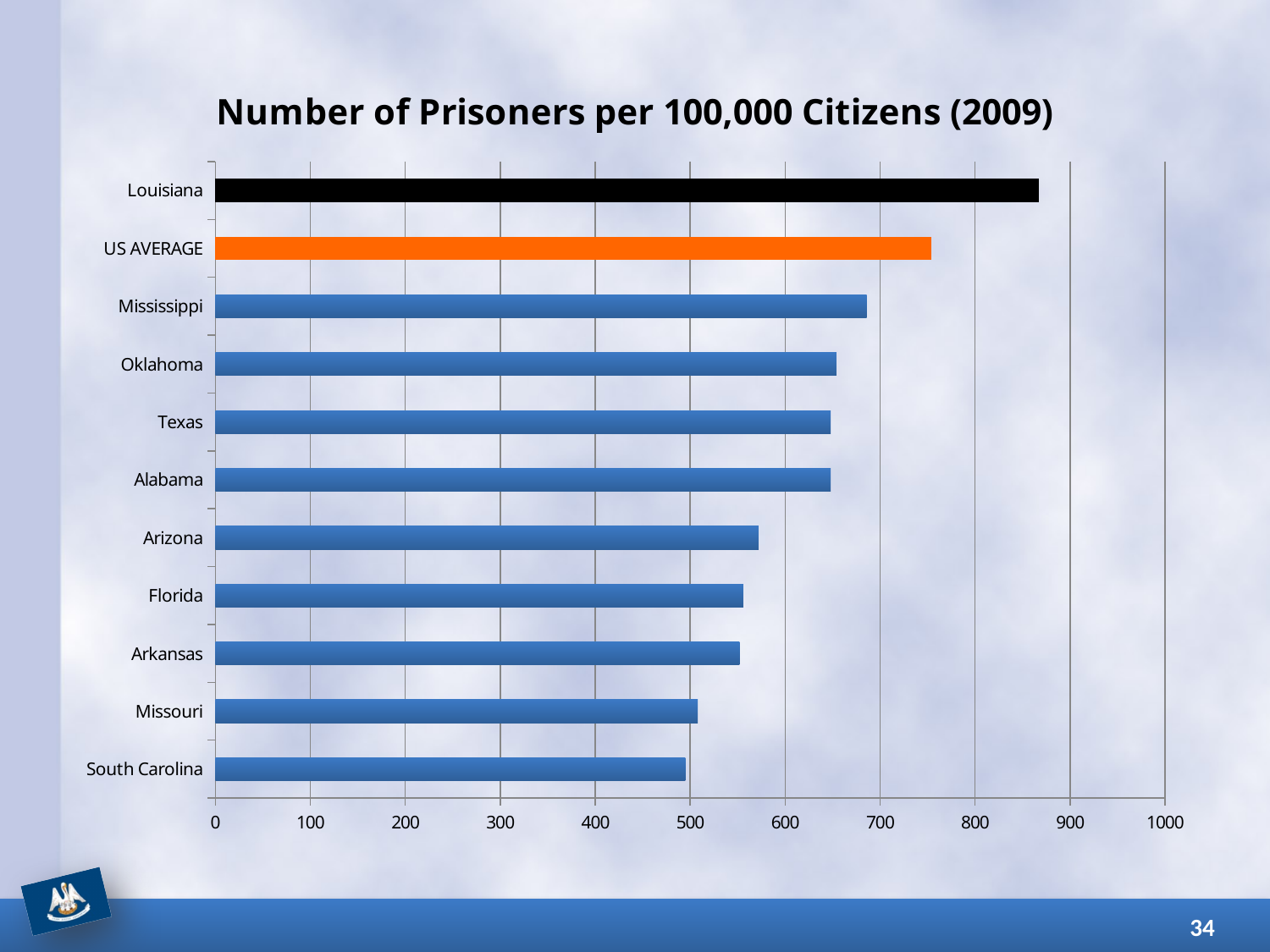
Is the value for US AVERAGE greater or less than 700? greater What colour is the bar for US AVERAGE? orange What is the title of the chart? Number of Prisoners per 100,000 Citizens (2009) What kind of chart is shown on the slide? bar chart Is the value for Louisiana greater or less than 800? greater Is the value for Mississippi greater or less than 700? less Which category has the highest number of prisoners per 100,000 citizens? Louisiana How many categories are plotted in the chart? 11 Which category has the lowest number of prisoners per 100,000 citizens? South Carolina Which is larger, the value for Louisiana or the value for US AVERAGE? Louisiana Which is larger, the value for Mississippi or the value for Oklahoma? Mississippi